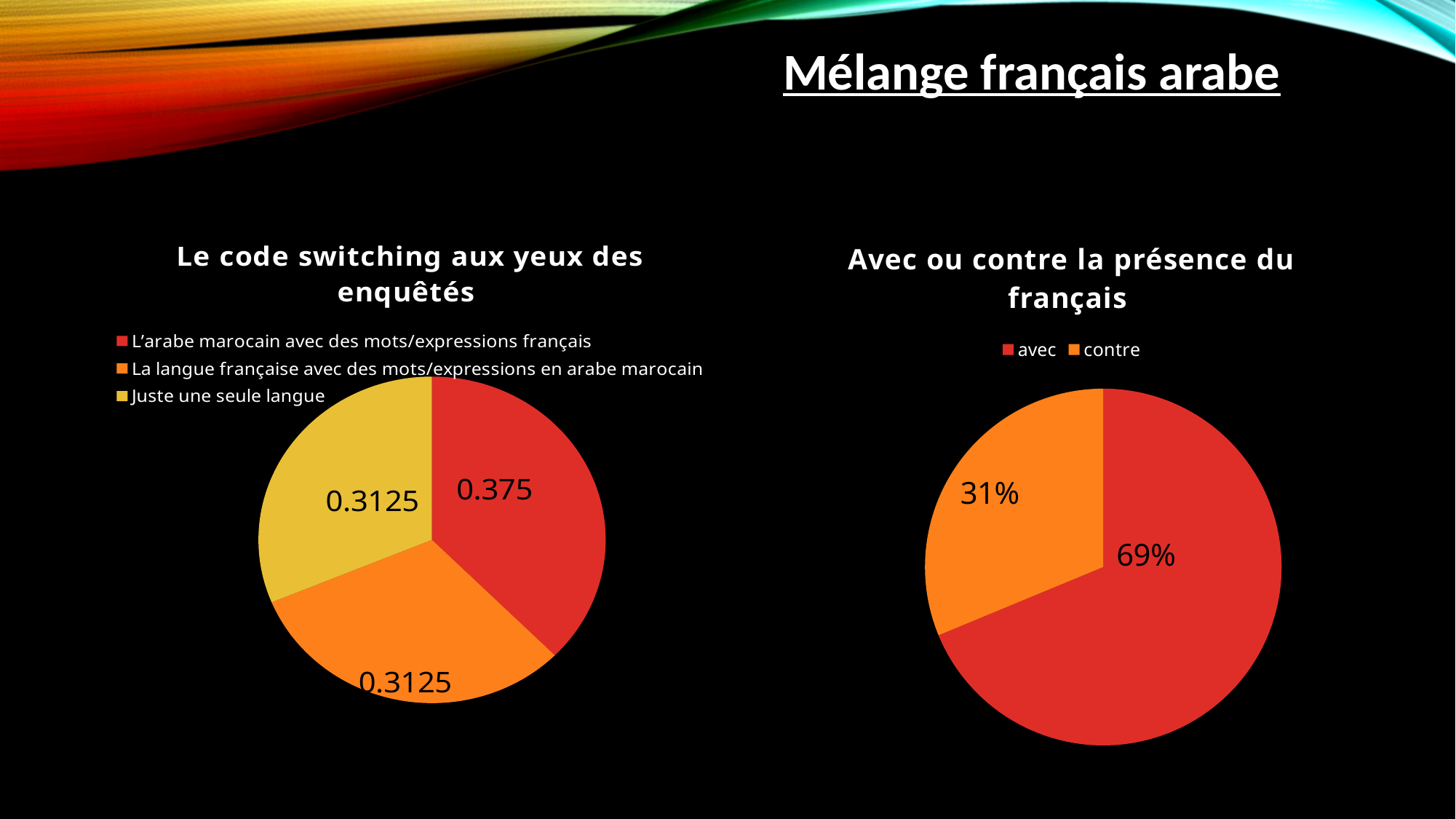
In the chart titled 'Avec ou contre la présence du français', what is the share for 'contre'? 31% In the chart titled 'Avec ou contre la présence du français', which category has the smallest slice? contre In the chart titled 'Avec ou contre la présence du français', what is the difference between the 'avec' and 'contre' shares? 38% In the chart titled 'Le code switching aux yeux des enquêtés', which category has the largest slice? L'arabe marocain avec des mots/expressions français In the chart titled 'Le code switching aux yeux des enquêtés', what is the value for 'Juste une seule langue'? 0.3125 What kind of chart is the one titled 'Le code switching aux yeux des enquêtés'? Pie chart In the chart titled 'Le code switching aux yeux des enquêtés', how many slices does the pie have? 3 In the chart titled 'Avec ou contre la présence du français', what is the share for 'avec'? 69% In the chart titled 'Avec ou contre la présence du français', what colour is the 'contre' slice? Orange In the chart titled 'Avec ou contre la présence du français', how many entries does the legend list? 2 In the chart titled 'Le code switching aux yeux des enquêtés', what is the value for 'L'arabe marocain avec des mots/expressions français'? 0.375 In the chart titled 'Le code switching aux yeux des enquêtés', what is the difference between the value for 'L'arabe marocain avec des mots/expressions français' and the value for 'La langue française avec des mots/expressions en arabe marocain'? 0.0625